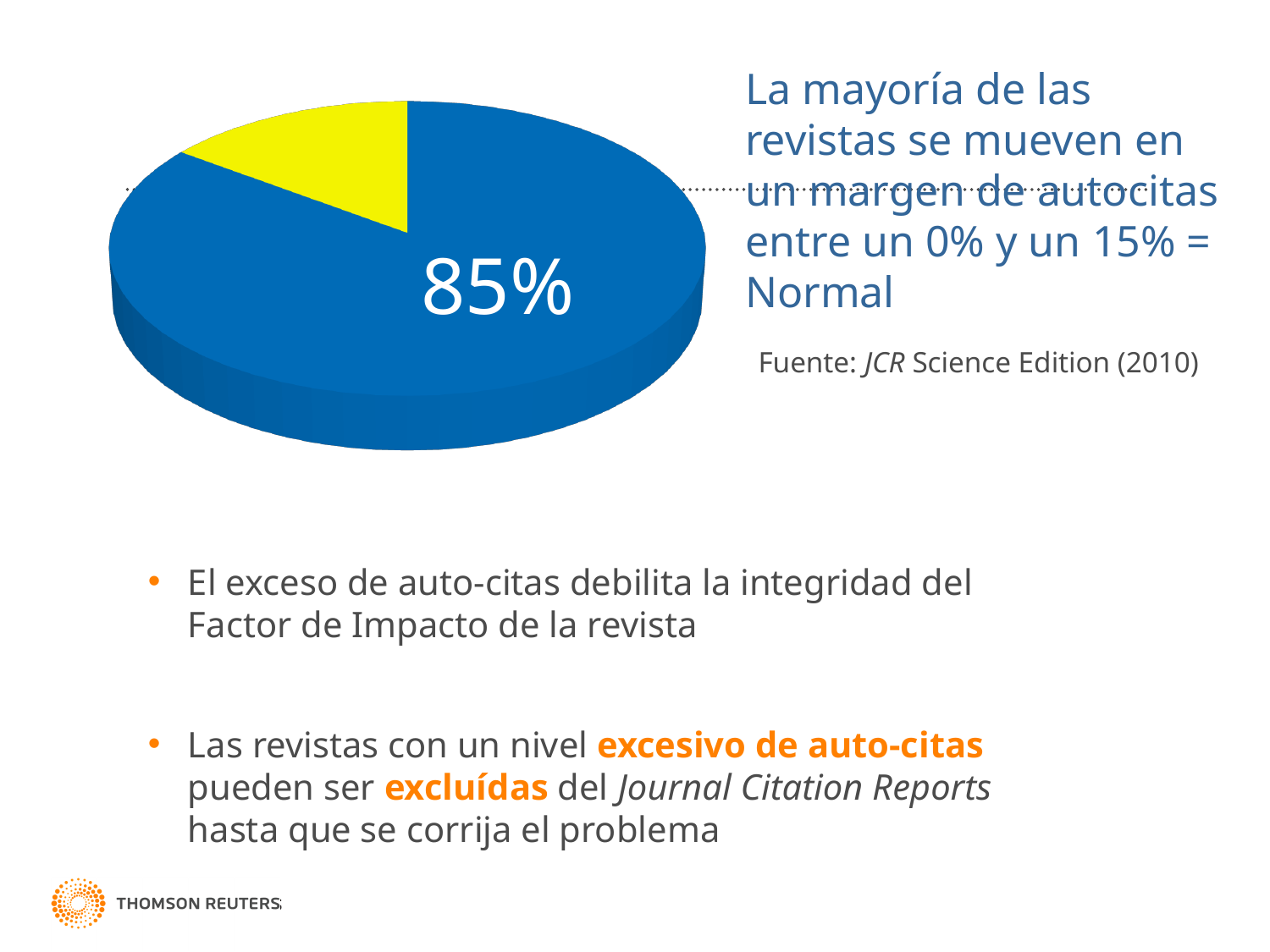
What source is cited next to the pie chart? JCR Science Edition (2010) What colour is the slice labelled 85%? blue What kind of chart is shown on the slide? pie chart What percentage is printed on the blue slice of the pie chart? 85% How many slices does the pie chart have? 2 Which slice is larger, the blue slice or the yellow slice? the blue slice Which slice of the pie chart is the smallest? the yellow slice Which slice of the pie chart is the largest? the blue slice What share of the pie does the blue slice represent? 85%